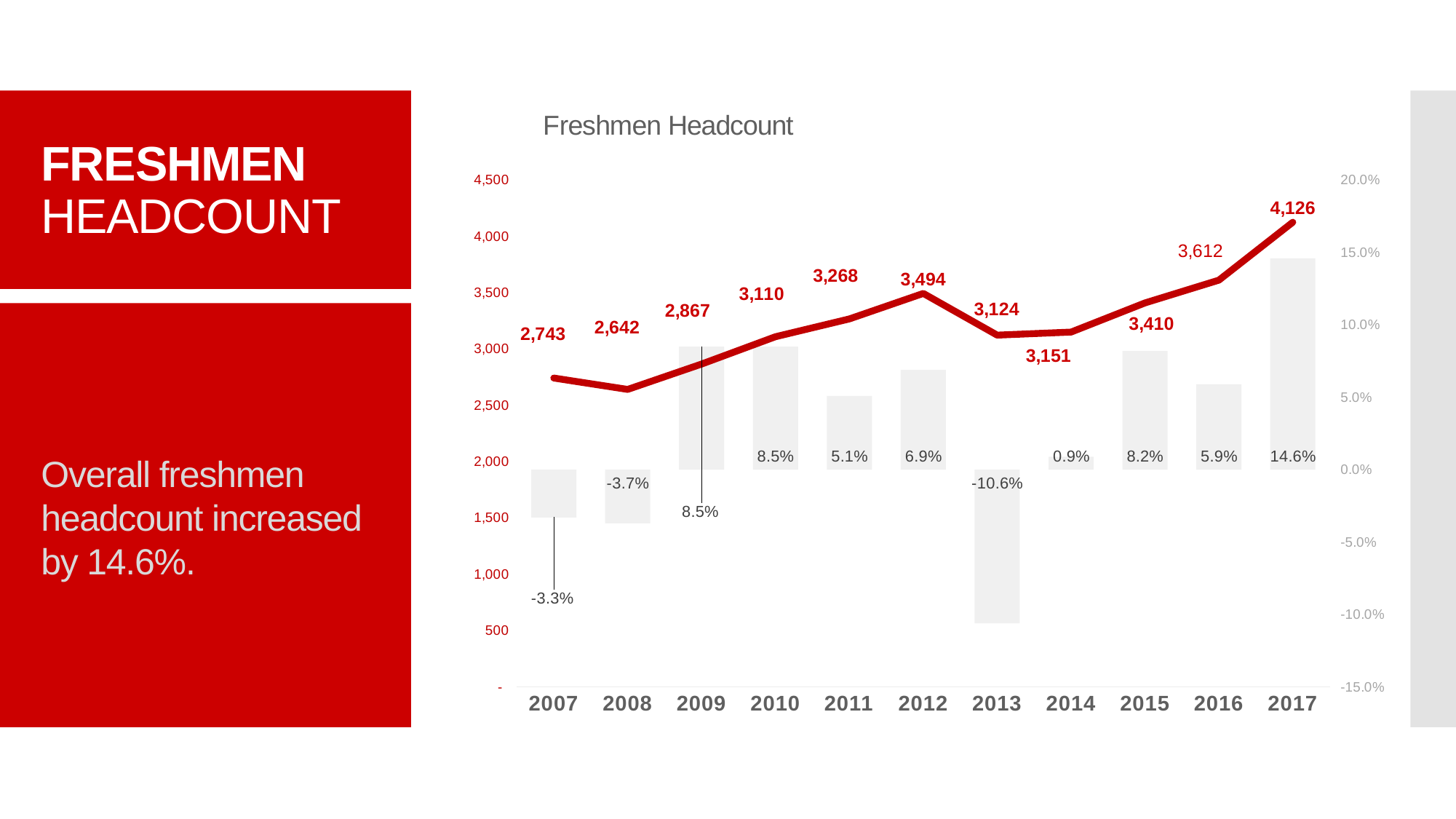
Which year has the lowest freshmen headcount? 2008 Which is larger, the freshmen headcount in 2012 or in 2015? 2012 How many years are shown on the x axis of the chart? 11 What is the difference in freshmen headcount between 2017 and 2016? 514 What is the freshmen headcount for 2012? 3,494 What percentage change is shown for 2010? 8.5% Which year shows the lowest percentage change? 2013 Which year has the highest freshmen headcount? 2017 Does the freshmen headcount line rise or fall from 2014 to 2017? rise What is the freshmen headcount for 2017? 4,126 What percentage change is shown for 2013? -10.6% What is the title of the chart? Freshmen Headcount